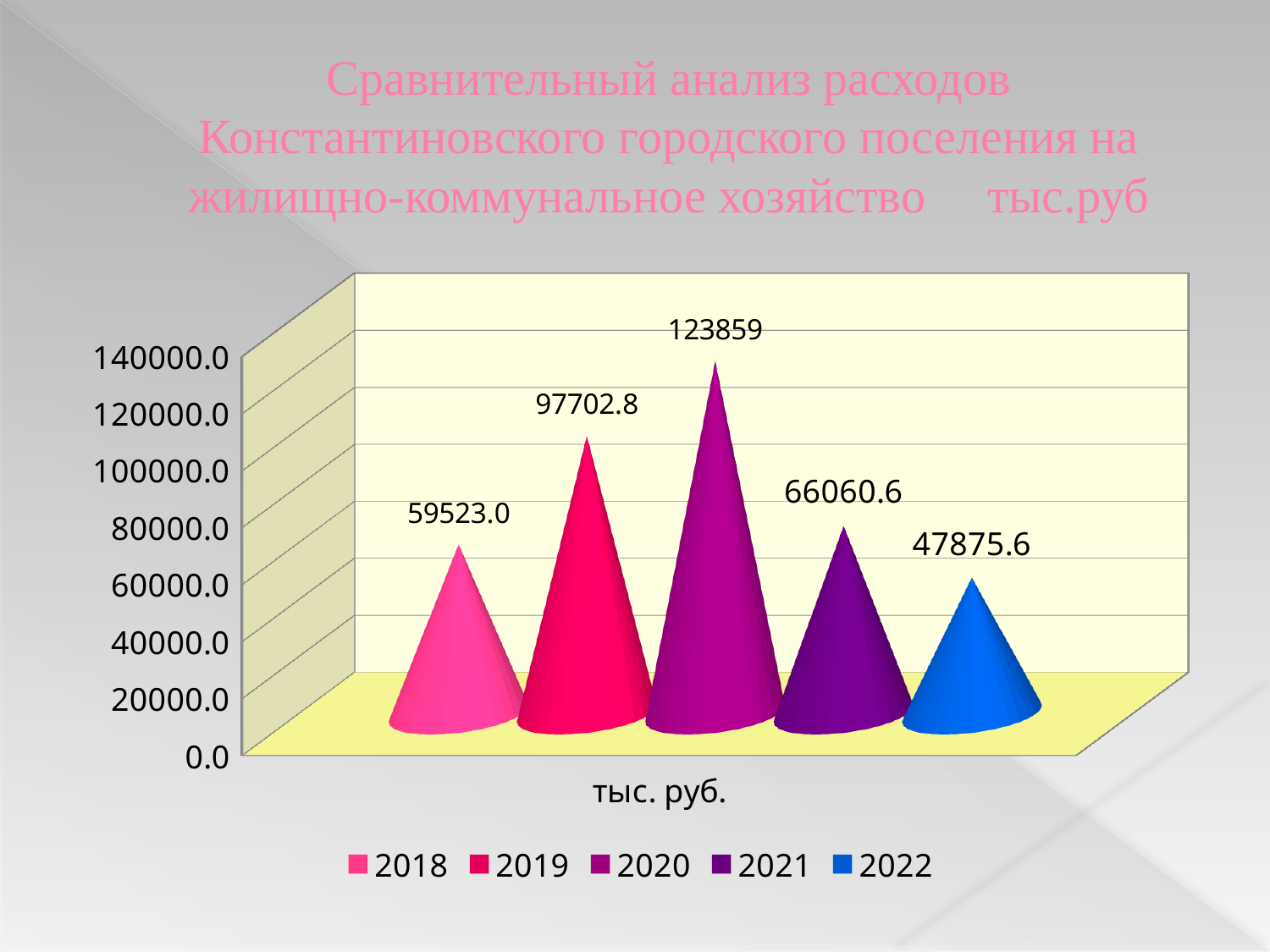
Which year has the lowest value? 2022 What is the value for 2019? 97702.8 Which is larger, the value for 2018 or the value for 2021? 2021 What is the value for 2020? 123859 What is the value for 2022? 47875.6 What is the difference between the values for 2021 and 2022? 18185.0 Which year has the highest value? 2020 What is the value for 2018? 59523.0 What is the value for 2021? 66060.6 What is the difference between the values for 2020 and 2019? 26156.2 What kind of chart is shown on the slide? bar chart How many series does the legend list? 5